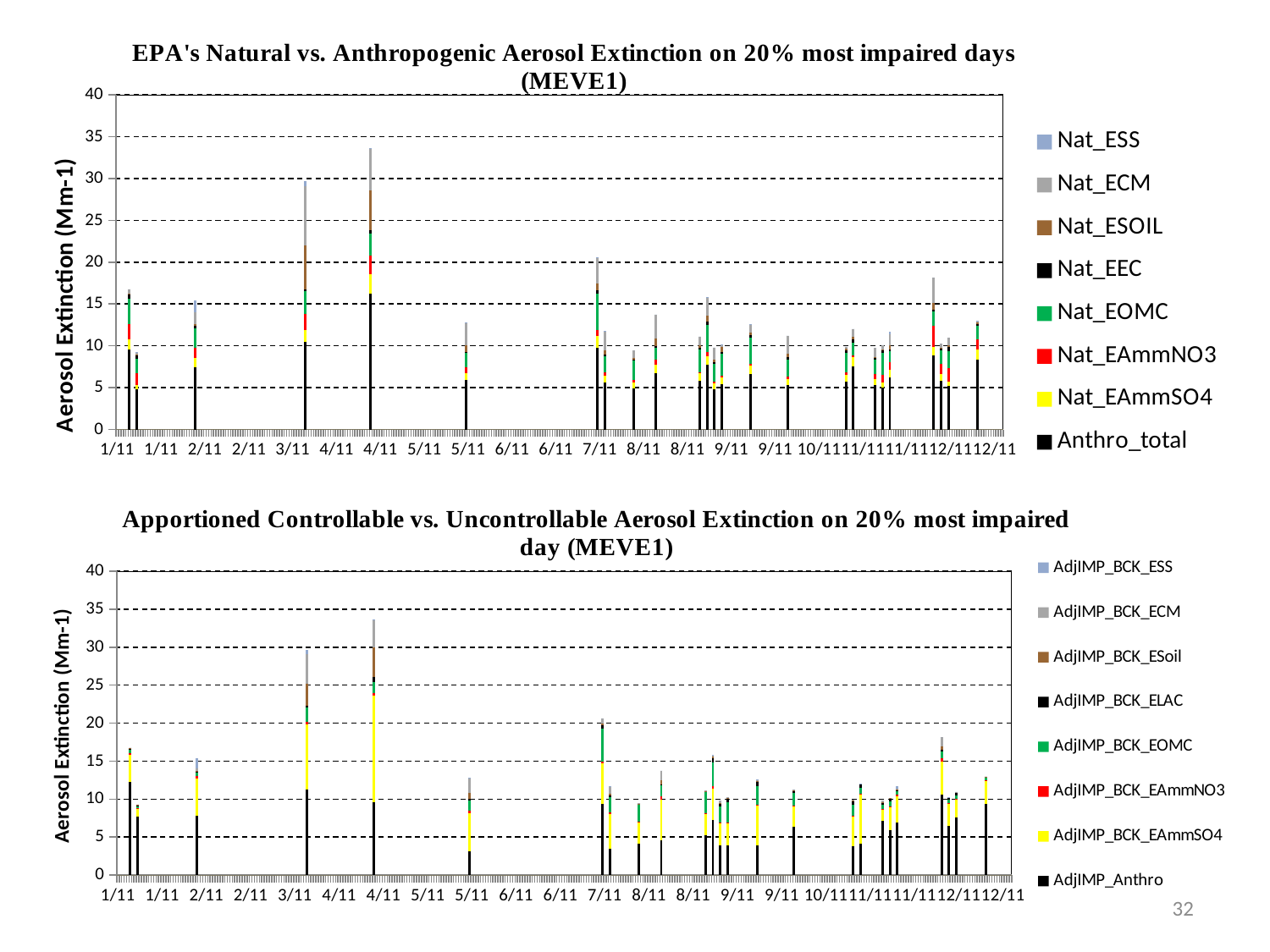
How many series does the legend of the top chart list? 8 In the top chart, near which x-axis date does the tallest bar occur? 4/11 In the top chart, is the tallest bar near 12/11 greater or less than 15? greater In the top chart, is the tallest bar (near 4/11) greater or less than 35? less In the bottom chart, is the bar at 5/11 greater or less than 15? less In the bottom chart, near which x-axis date does the tallest bar occur? 4/11 How many series does the legend of the bottom chart list? 8 What is the y-axis label of the top chart? Aerosol Extinction (Mm-1) What is the last legend entry of the bottom chart? AdjIMP_Anthro What kind of chart is the bottom chart on the slide? Stacked bar chart What kind of chart is the top chart on the slide? Stacked bar chart